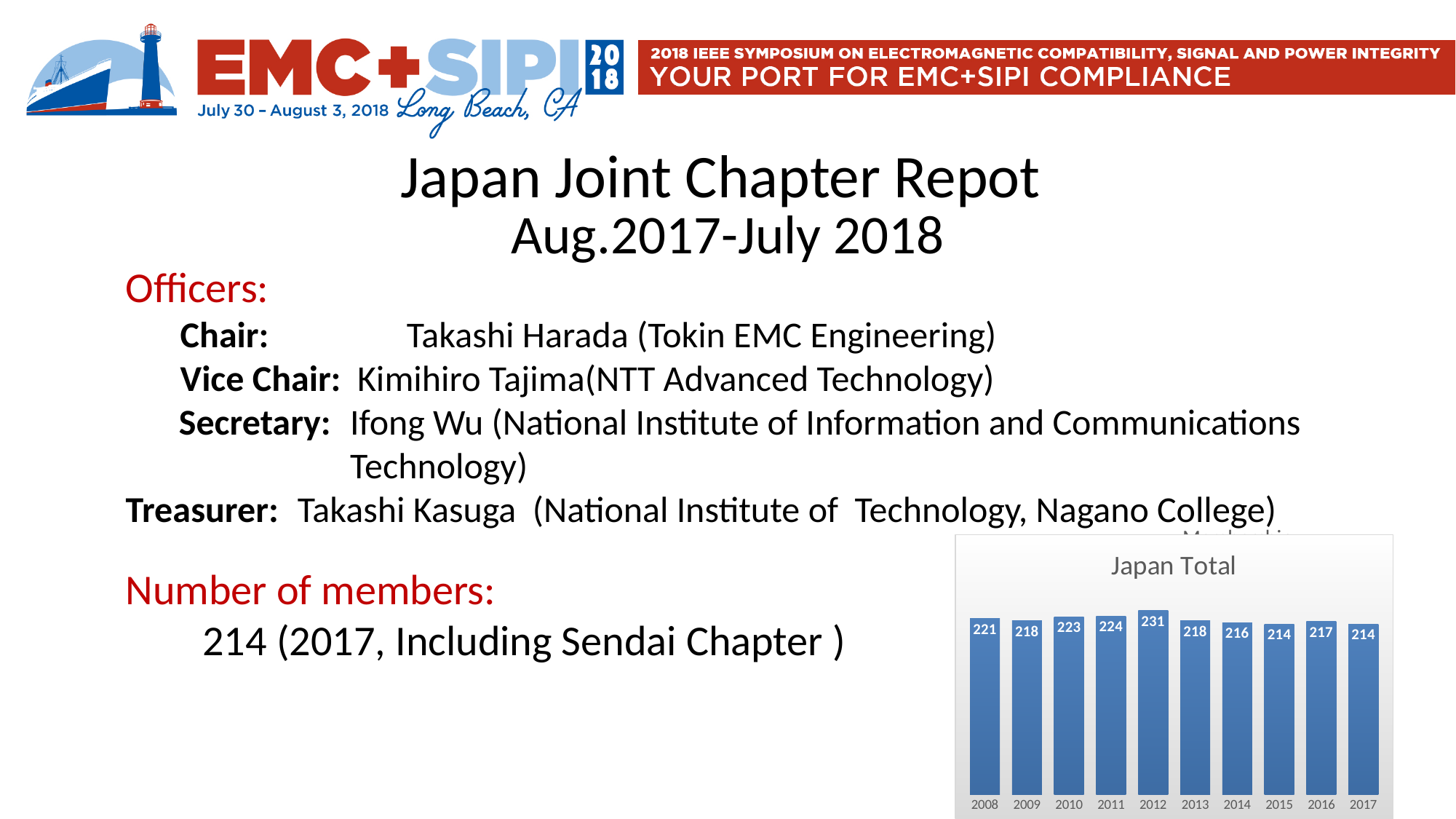
Which year has the highest value in the Japan Total chart? 2012 What is the difference between the values for 2012 and 2008 in the Japan Total chart? 10 What is the title of the chart on the slide? Japan Total What is the value for 2017 in the Japan Total chart? 214 What is the value for 2012 in the Japan Total chart? 231 What is the value for 2014 in the Japan Total chart? 216 What is the lowest value shown in the Japan Total chart? 214 What is the value for 2008 in the Japan Total chart? 221 How many years are shown in the Japan Total chart? 10 In the Japan Total chart, which is larger, the value for 2010 or the value for 2009? 2010 What kind of chart is the Japan Total chart? Bar chart What is the difference between the values for 2011 and 2017 in the Japan Total chart? 10